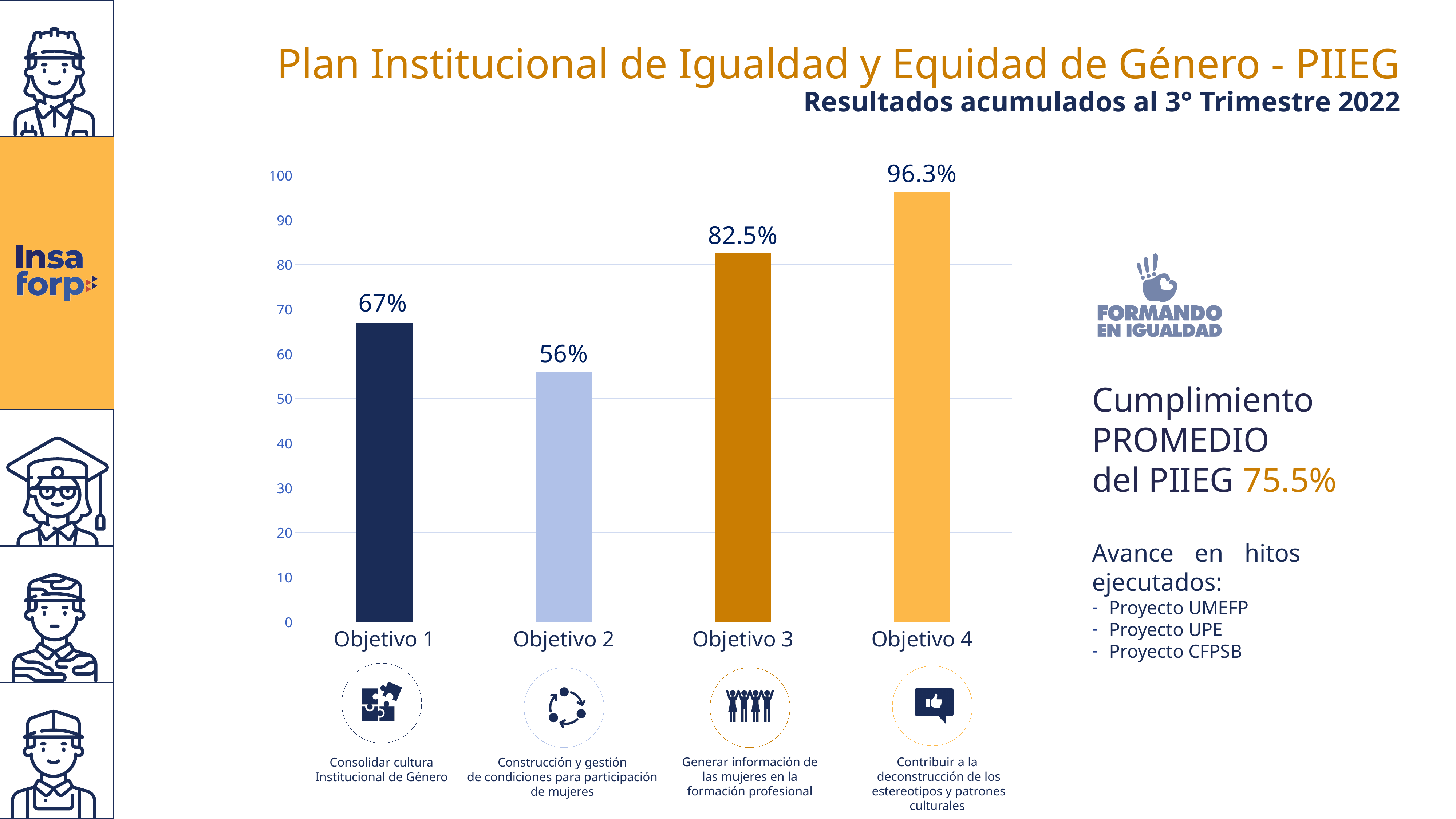
Which is larger, the value for Objetivo 1 or Objetivo 3? Objetivo 3 What is the value for Objetivo 2? 56% Which objetivo has the highest value? Objetivo 4 What kind of chart is shown on the slide? Bar chart What is the value for Objetivo 3? 82.5% What is the value for Objetivo 4? 96.3% Which objetivo has the lowest value? Objetivo 2 What colour is the bar for Objetivo 2? Light blue What is the difference between the values for Objetivo 4 and Objetivo 3? 13.8% What is the difference between the values for Objetivo 1 and Objetivo 2? 11% What is the value for Objetivo 1? 67% How many objetivos are plotted in the chart? 4